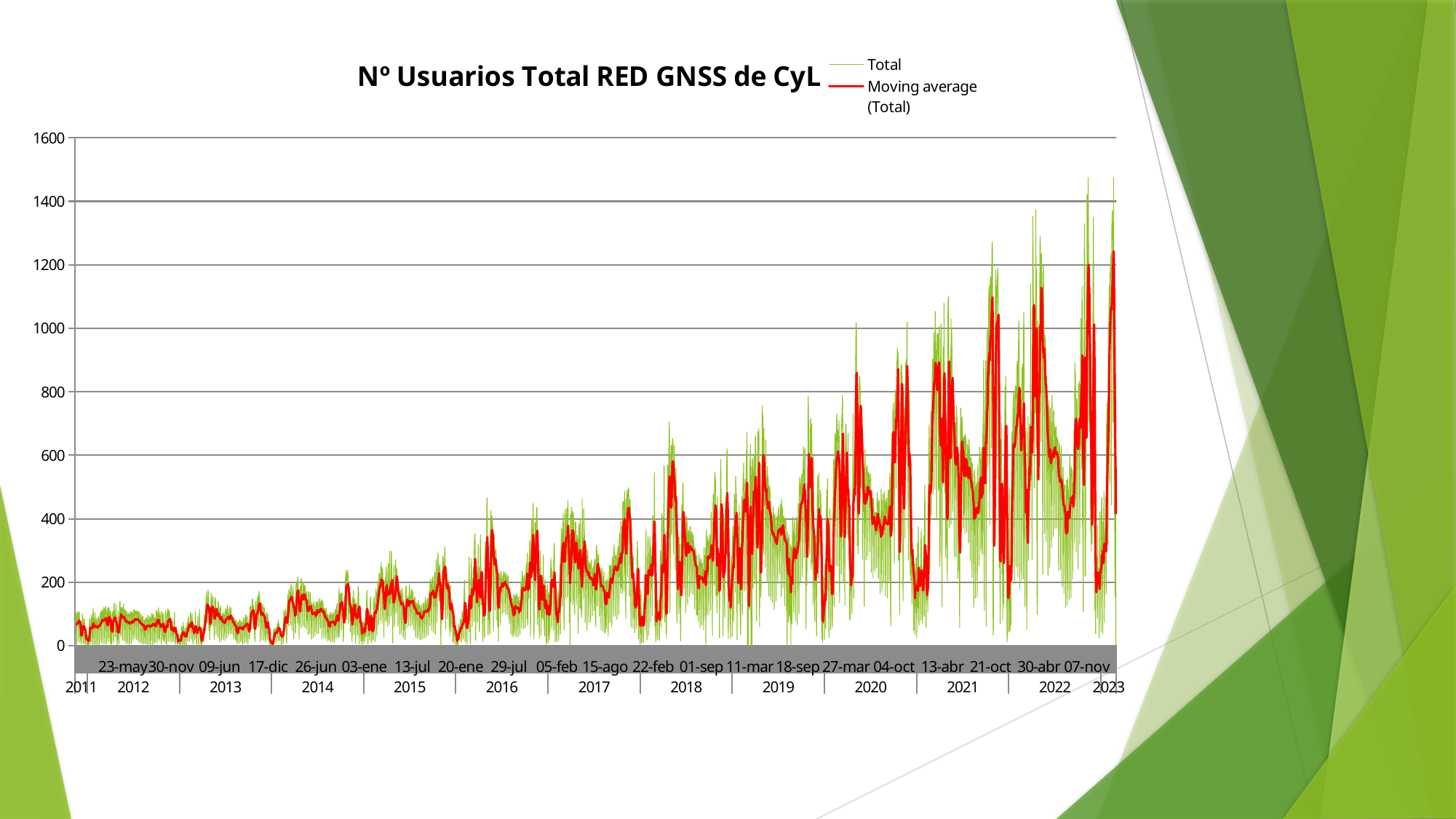
Are the Total values higher in 2022 or in 2012? 2022 How many year labels appear along the x axis? 13 What kind of chart is shown on the slide? Line chart Which colour is used for the Moving average (Total) series? Red Overall, do the values rise or fall from 2011 to 2023? Rise Is the highest peak of the Total series greater or less than 1400? greater Is the Total value during 2011 greater or less than 200? less Is the Moving average (Total) during 2013 greater or less than 400? less How many series does the legend list? 2 What is the title of the chart? Nº Usuarios Total RED GNSS de CyL